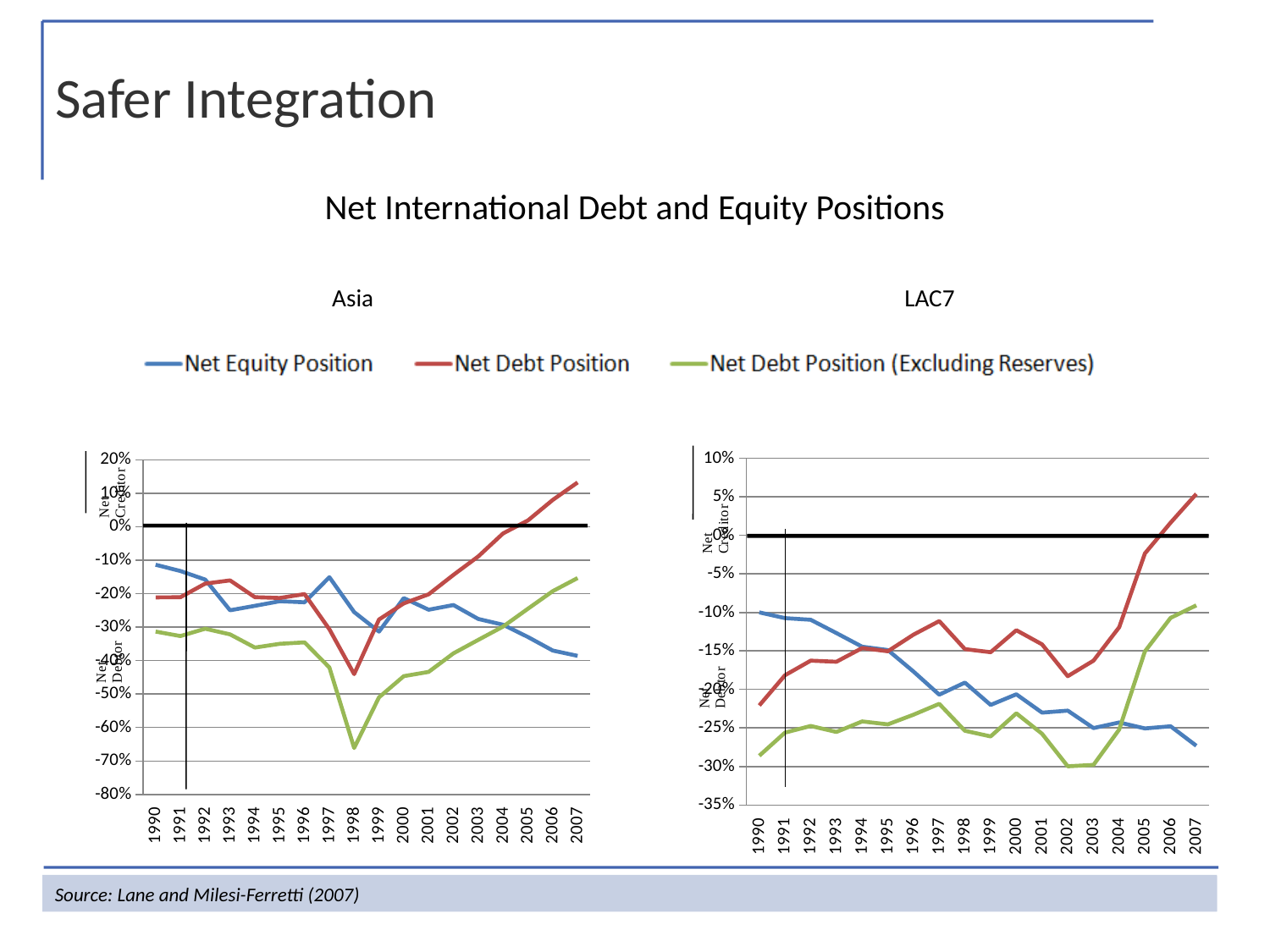
In the Asia chart, which series is higher in 2007, Net Debt Position or Net Equity Position? Net Debt Position In the Asia chart, is the Net Equity Position value for 2007 greater or less than -30%? less In the LAC7 chart, is the Net Debt Position value for 2007 greater or less than 0%? greater In the Asia chart, is the Net Debt Position value for 2007 greater or less than 10%? greater What kind of chart is the Asia chart? line chart In the LAC7 chart, which year has the highest Net Debt Position value? 2007 In the Asia chart, which year has the lowest Net Debt Position (Excluding Reserves) value? 1998 In the Asia chart, does the Net Equity Position rise or fall overall from 1990 to 2007? fall How many series does the legend list for the charts? 3 How many years are plotted on the x axis of the LAC7 chart? 18